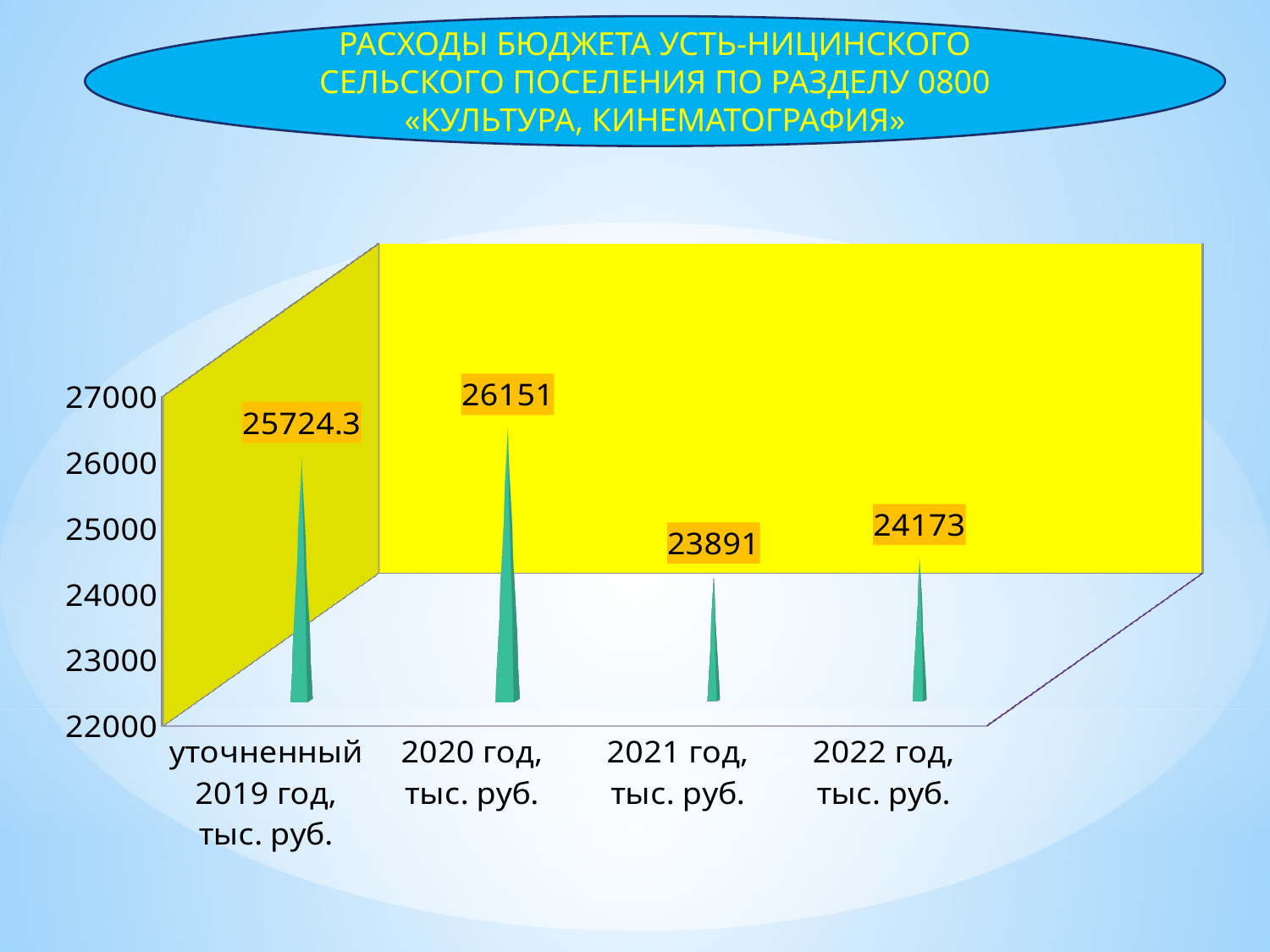
What is the difference between the values for 2020 год and 2021 год? 2260 What is the value for 2022 год, тыс. руб.? 24173 What is the value for уточненный 2019 год, тыс. руб.? 25724.3 What is the value for 2021 год, тыс. руб.? 23891 Which category has the highest value? 2020 год, тыс. руб. Which is larger, the value for уточненный 2019 год or the value for 2022 год? уточненный 2019 год, тыс. руб. Does the value rise or fall from 2020 год to 2021 год? fall What is the difference between the values for 2022 год and 2021 год? 282 What kind of chart is shown on the slide? bar chart Which category has the lowest value? 2021 год, тыс. руб. What is the value for 2020 год, тыс. руб.? 26151 How many categories are shown on the x axis? 4